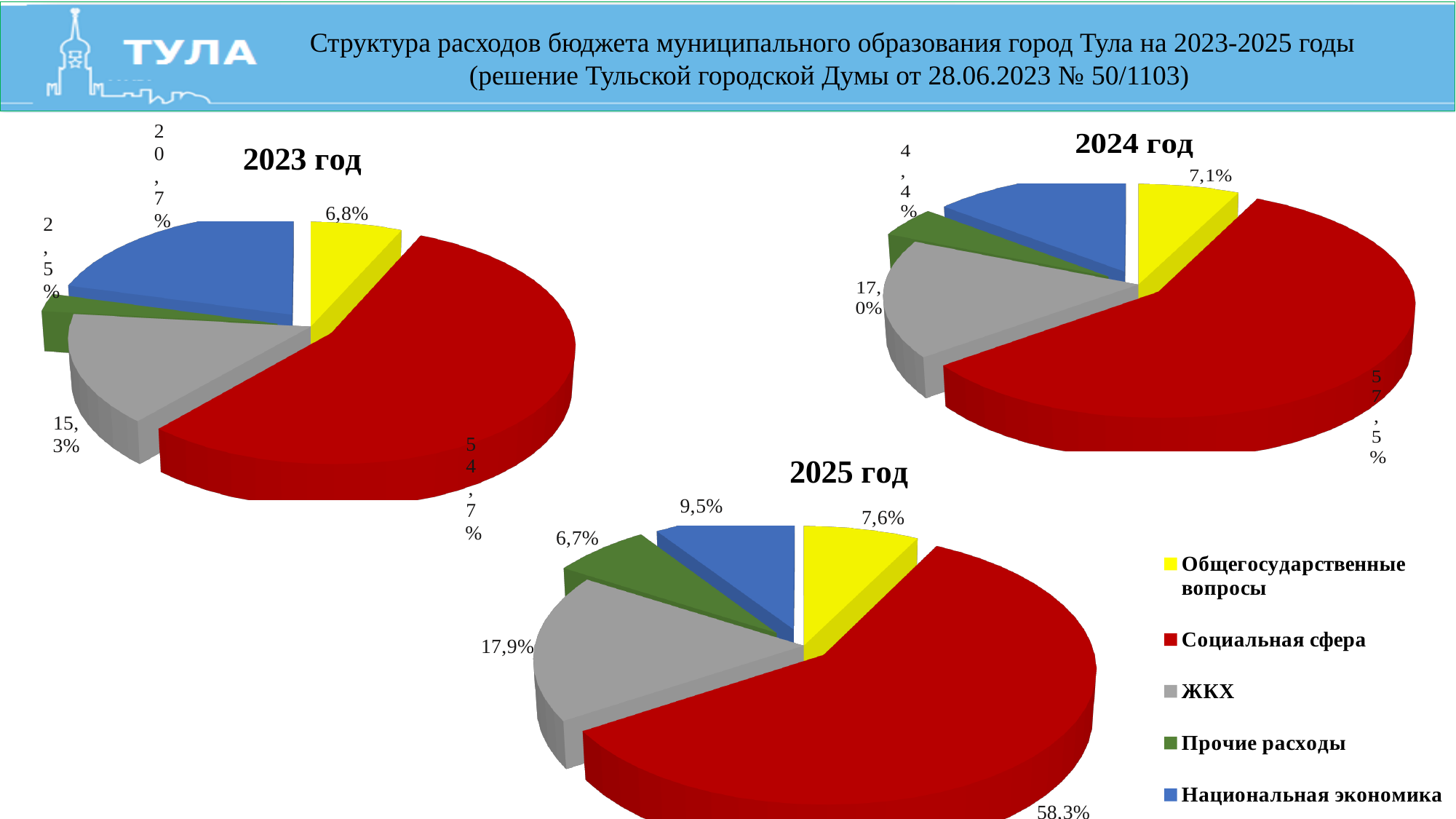
In the 2025 год chart, what share is Общегосударственные вопросы? 7,6% In the 2023 год chart, which category has the smallest share? Прочие расходы How many categories does the legend list? 5 In the 2023 год chart, what share is Национальная экономика? 20,7% In the 2023 год chart, what share is Социальная сфера? 54,7% In the 2023 год chart, which is larger: ЖКХ or Национальная экономика? Национальная экономика In the 2025 год chart, what is the difference between the shares of ЖКХ and Национальная экономика? 8,4% What type of chart is the 2025 год chart? Pie chart In the 2025 год chart, what share is Прочие расходы? 6,7% In the 2024 год chart, what share is ЖКХ? 17,0% In the 2024 год chart, which category has the largest share? Социальная сфера Which colour represents Социальная сфера in the legend? Red